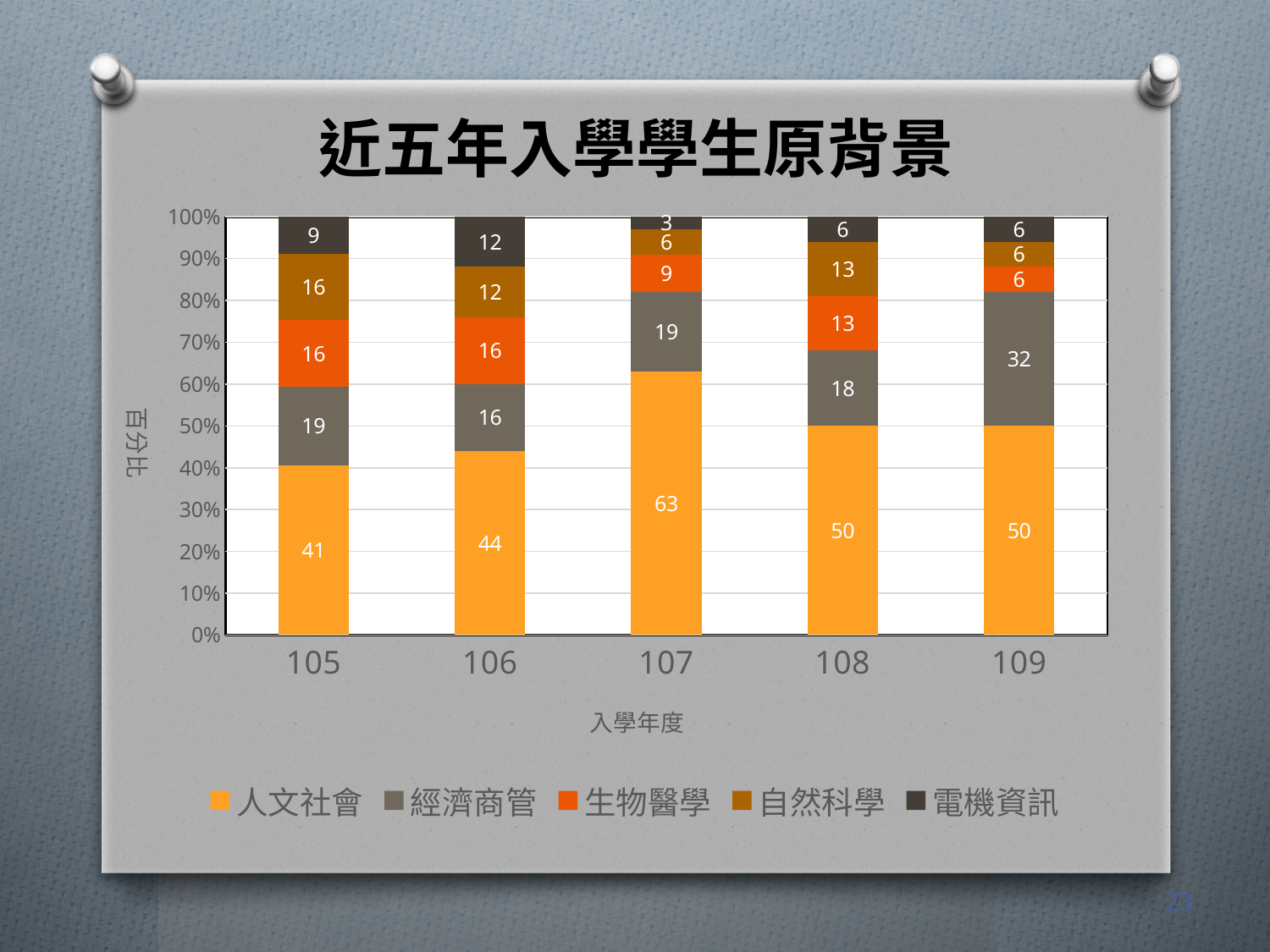
Which is larger, the 經濟商管 value for 109 or for 108? 109 What kind of chart is shown on the slide? Stacked bar chart How many years are shown on the x axis? 5 Which year has the lowest value for 電機資訊? 107 How many series does the legend list? 5 What is the title of the chart? 近五年入學學生原背景 What is the value of 人文社會 for 107? 63 What is the difference between the 人文社會 values for 107 and 105? 22 What is the value of 經濟商管 for 109? 32 Which year has the highest value for 人文社會? 107 What is the value of 生物醫學 for 108? 13 What is the value of 電機資訊 for 106? 12